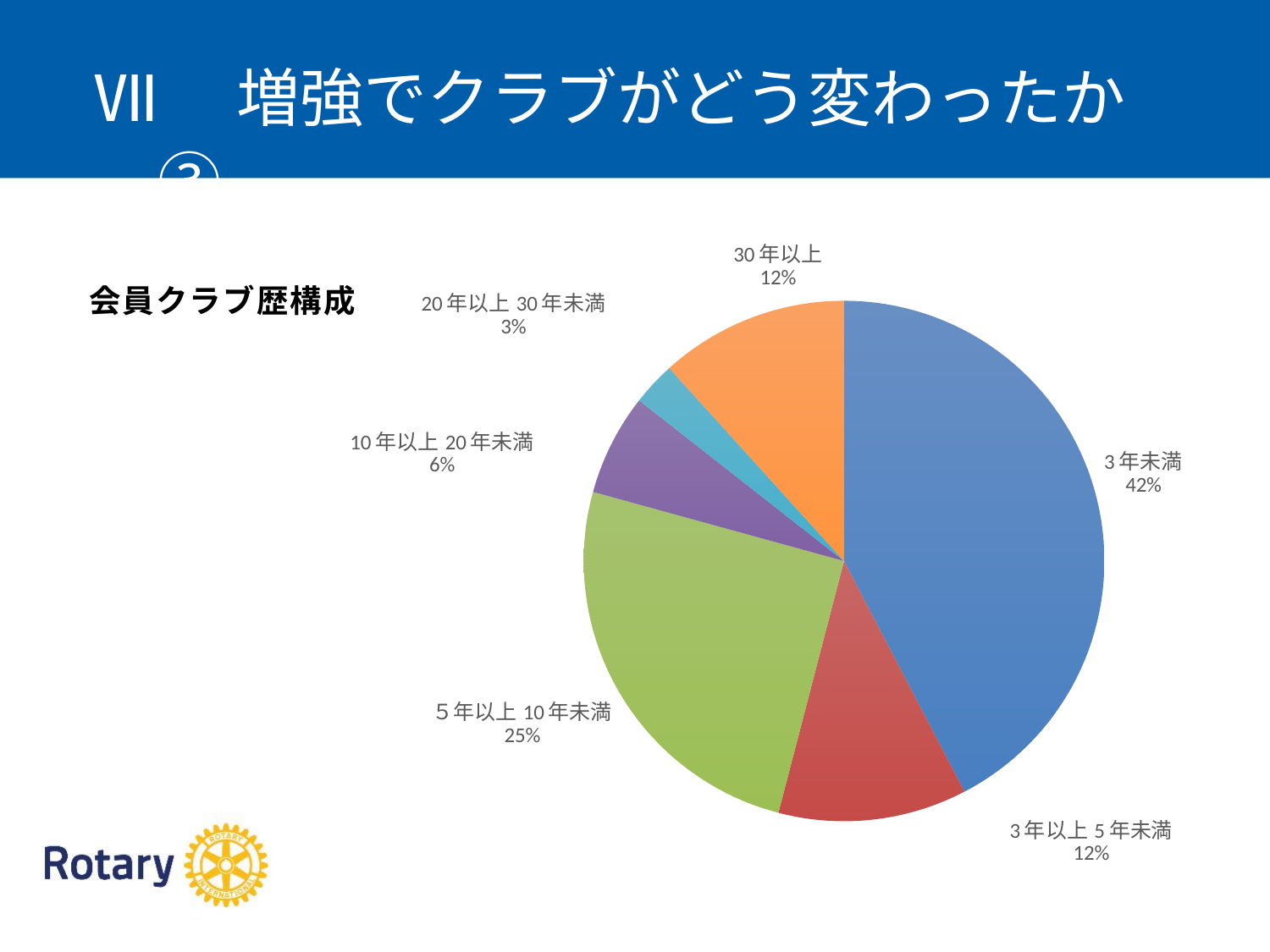
What kind of chart is shown on the slide? pie chart Which category has the largest share of the pie? 3年未満 What is the value for 10年以上 20年未満? 6% What is the value for 5年以上 10年未満? 25% Which category has the smallest share of the pie? 20年以上 30年未満 What is the title of the pie chart? 会員クラブ歴構成 Which is larger, the share for 10年以上 20年未満 or the share for 3年以上 5年未満? 3年以上 5年未満 What share of the pie does the 3年未満 slice represent? 42% What is the value for 30年以上? 12% How many slices does the pie chart have? 6 What is the difference between the shares of 3年未満 and 5年以上 10年未満? 17% What is the value for 20年以上 30年未満? 3%